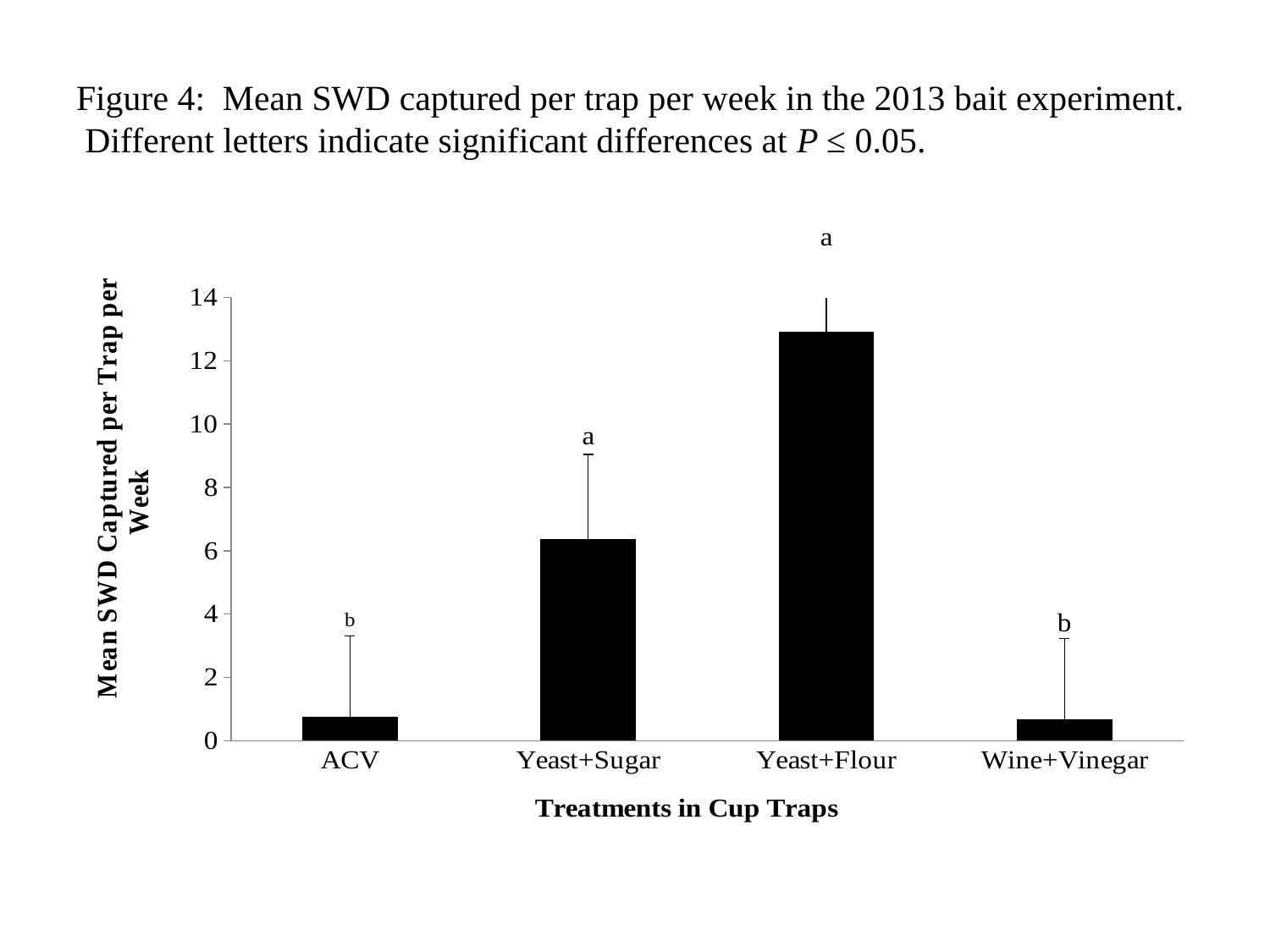
What is the title of the x axis of the chart? Treatments in Cup Traps Is the value for Wine+Vinegar greater or less than 2? less Is the value for ACV greater or less than 2? less Which treatment has the highest mean SWD captured per trap per week? Yeast+Flour Is the value for Yeast+Sugar greater or less than 8? less Which significance letter is printed above the Yeast+Flour bar? a How many treatments are shown on the x axis of the chart? 4 Which has a larger mean SWD captured per trap per week, Yeast+Sugar or Yeast+Flour? Yeast+Flour What kind of chart is shown on the slide? bar chart